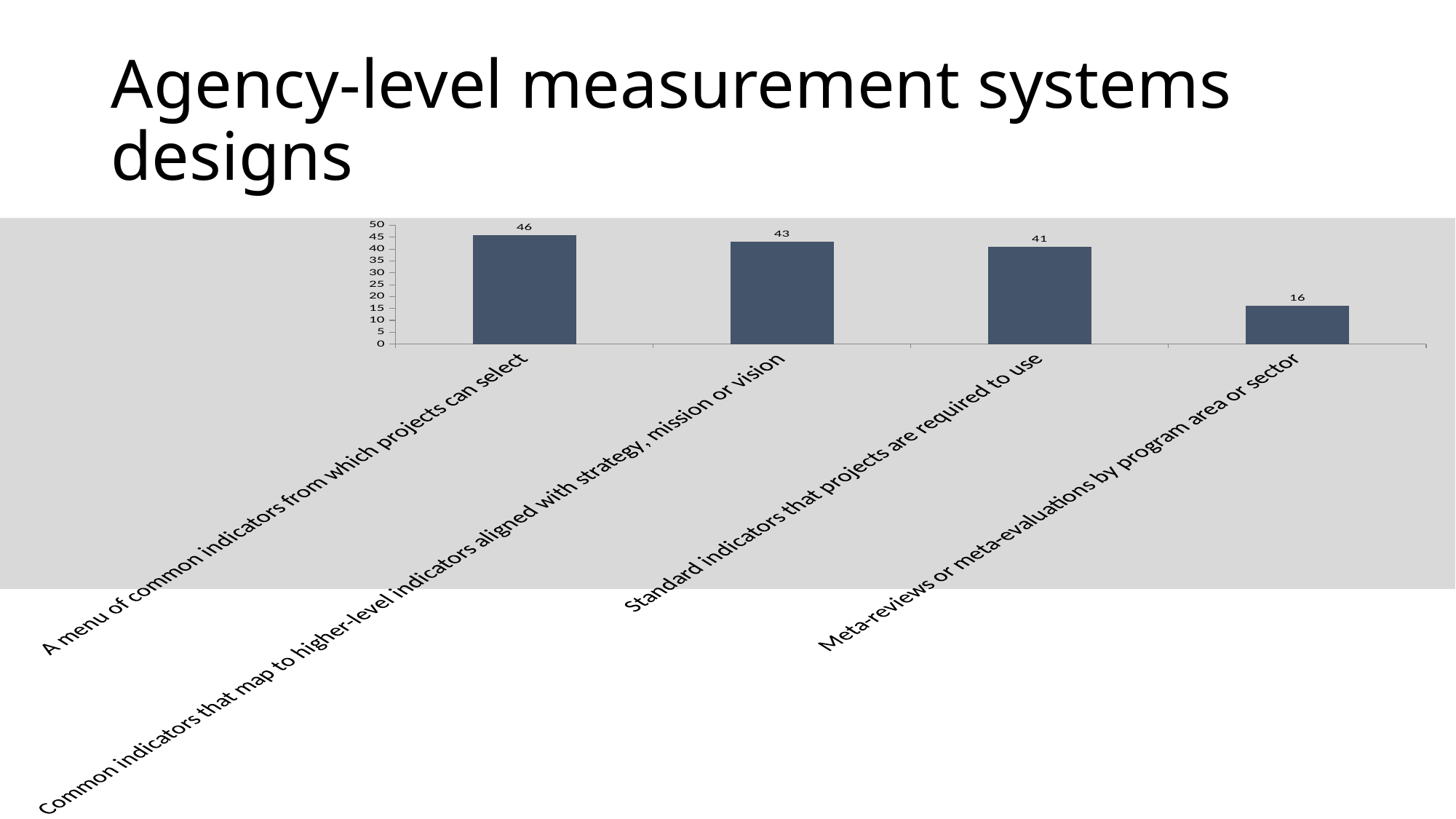
What is the value for 'Common indicators that map to higher-level indicators aligned with strategy, mission or vision'? 43 Which is larger: the value for 'Common indicators that map to higher-level indicators aligned with strategy, mission or vision' or the value for 'Standard indicators that projects are required to use'? Common indicators that map to higher-level indicators aligned with strategy, mission or vision What is the value for 'Meta-reviews or meta-evaluations by program area or sector'? 16 What is the difference between the values for 'A menu of common indicators from which projects can select' and 'Meta-reviews or meta-evaluations by program area or sector'? 30 Which category has the lowest value? Meta-reviews or meta-evaluations by program area or sector Is the value for 'Meta-reviews or meta-evaluations by program area or sector' greater or less than 20? less How many categories are shown in the chart? 4 Which category has the highest value? A menu of common indicators from which projects can select What kind of chart is shown on the slide? bar chart What is the value for 'Standard indicators that projects are required to use'? 41 Do the values rise or fall from left to right along the x axis? fall What is the value for 'A menu of common indicators from which projects can select'? 46